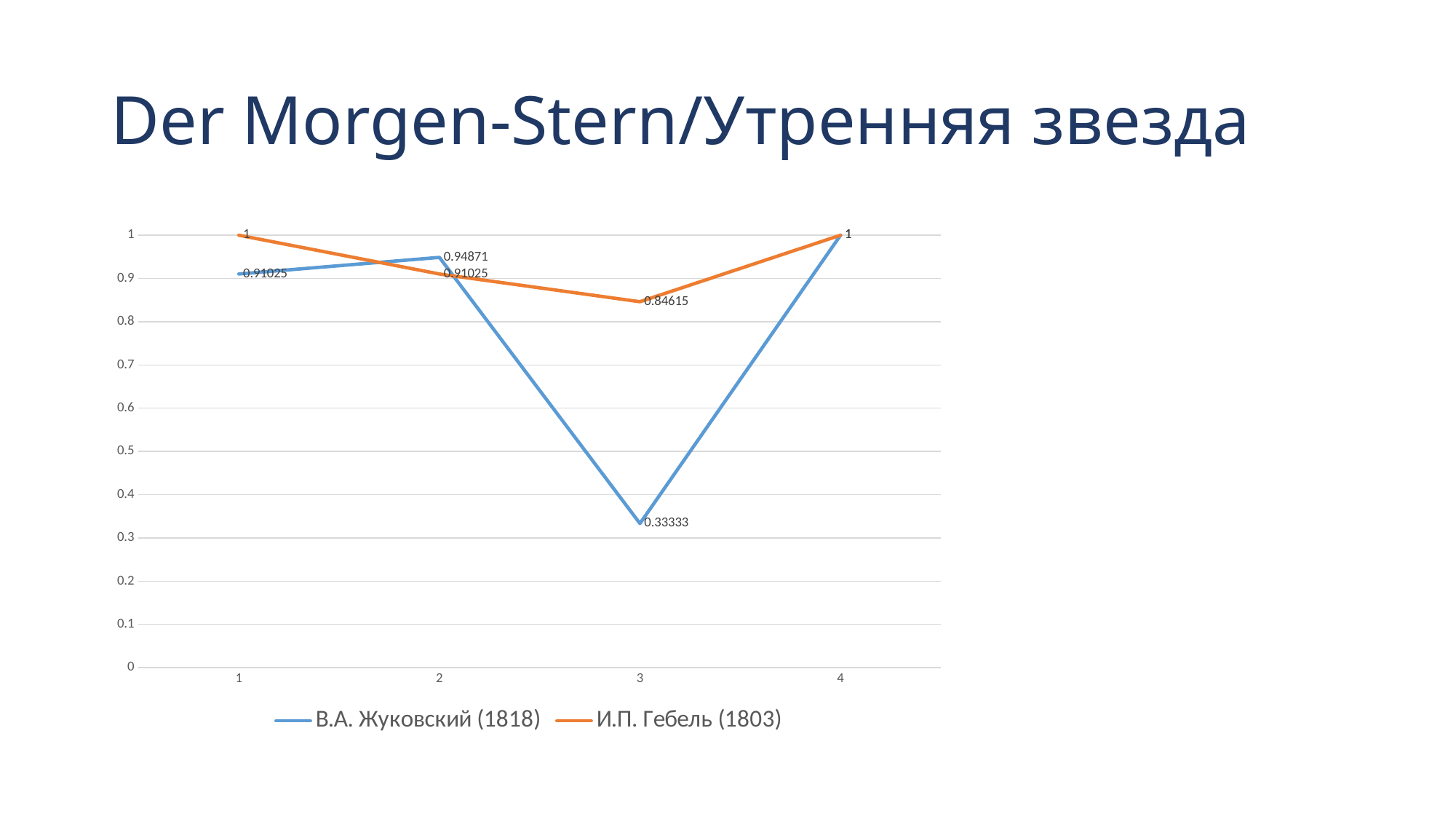
What is the value for В.А. Жуковский (1818) at point 2? 0.94871 At which point does И.П. Гебель (1803) have its lowest value? 3 Is the value for В.А. Жуковский (1818) at point 3 greater or less than 0.5? less How many points are plotted along the x axis for each series? 4 What is the value for И.П. Гебель (1803) at point 1? 1 What is the difference between the values of И.П. Гебель (1803) and В.А. Жуковский (1818) at point 3? 0.51282 What is the value for И.П. Гебель (1803) at point 3? 0.84615 At which point does В.А. Жуковский (1818) have its lowest value? 3 What kind of chart is shown on the slide? line chart How many series does the legend list? 2 Which series has the larger value at point 3, В.А. Жуковский (1818) or И.П. Гебель (1803)? И.П. Гебель (1803) What is the value for В.А. Жуковский (1818) at point 3? 0.33333